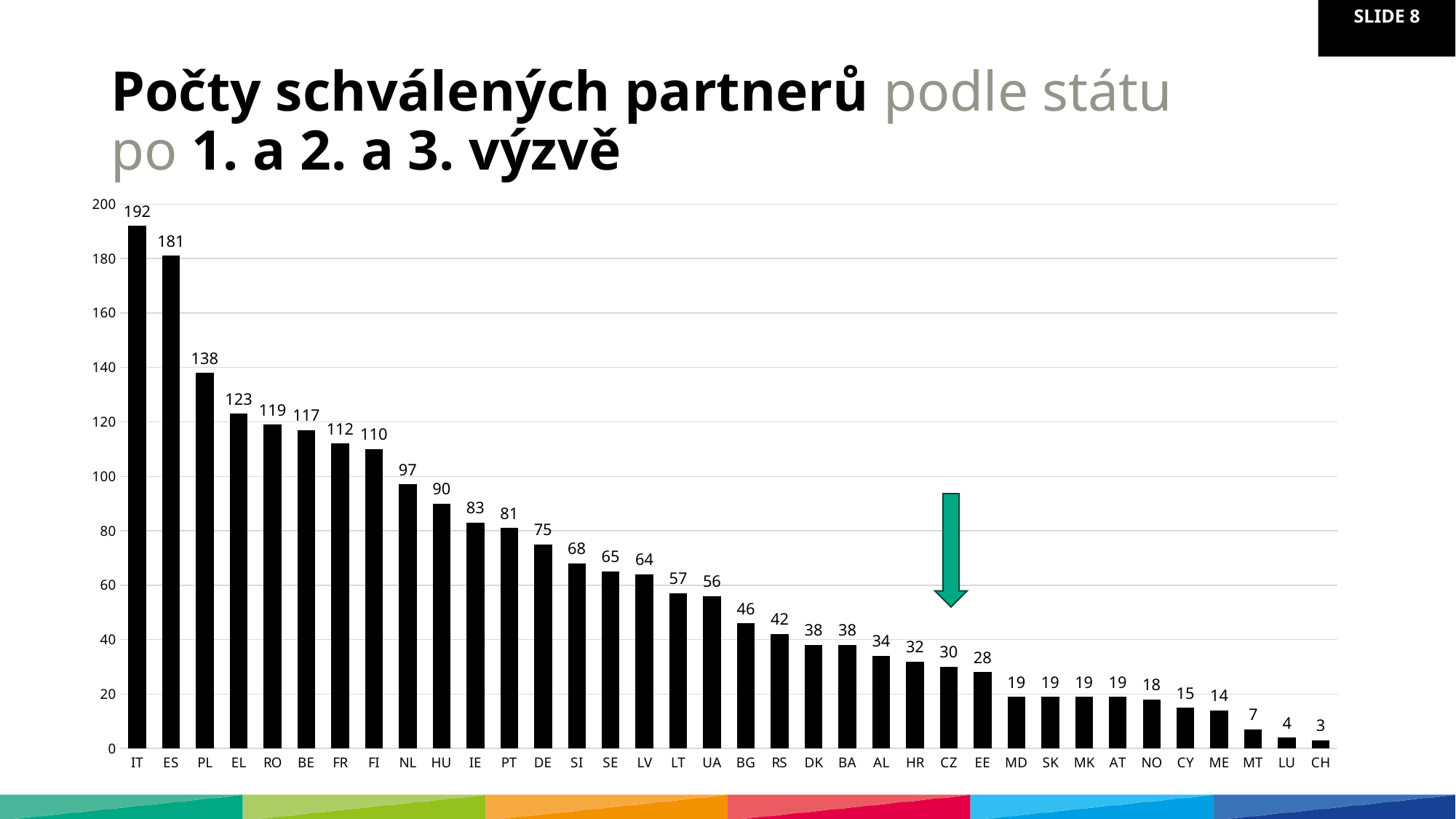
Which country has the lowest value? CH What is the value for NL? 97 Which country has the highest value? IT What is the difference between the values for PL and CZ? 108 Is the value for FR greater or less than 100? greater Do the values rise or fall from left to right along the x axis? fall What is the difference between the values for IT and ES? 11 What is the value for CZ? 30 What is the value for IT? 192 How many countries are shown on the x axis? 36 Which is larger, the value for HU or the value for IE? HU What kind of chart is shown on the slide? bar chart